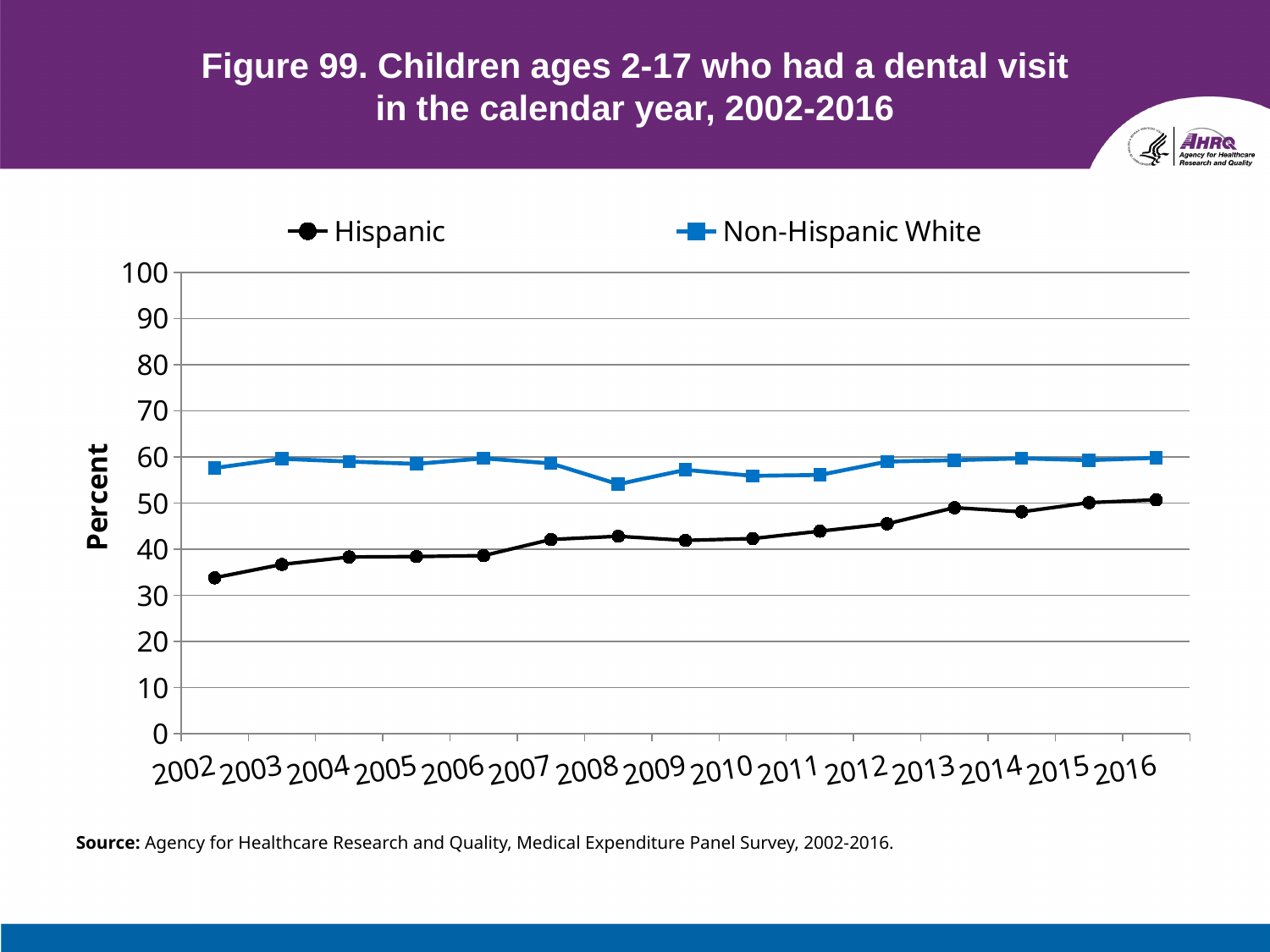
Is the Hispanic value for 2002 greater or less than 40? less How many years are plotted along the x axis? 15 In which year is the Hispanic value lowest? 2002 What is the label of the vertical axis? Percent Does the Hispanic series generally rise or fall from 2002 to 2016? rise Is the Non-Hispanic White value for 2008 greater or less than 60? less What kind of chart is shown on the slide? line chart In which year is the Non-Hispanic White value lowest? 2008 Is the Hispanic value for 2016 greater or less than 40? greater Which series has the lower values throughout the chart, Hispanic or Non-Hispanic White? Hispanic How many series does the legend list? 2